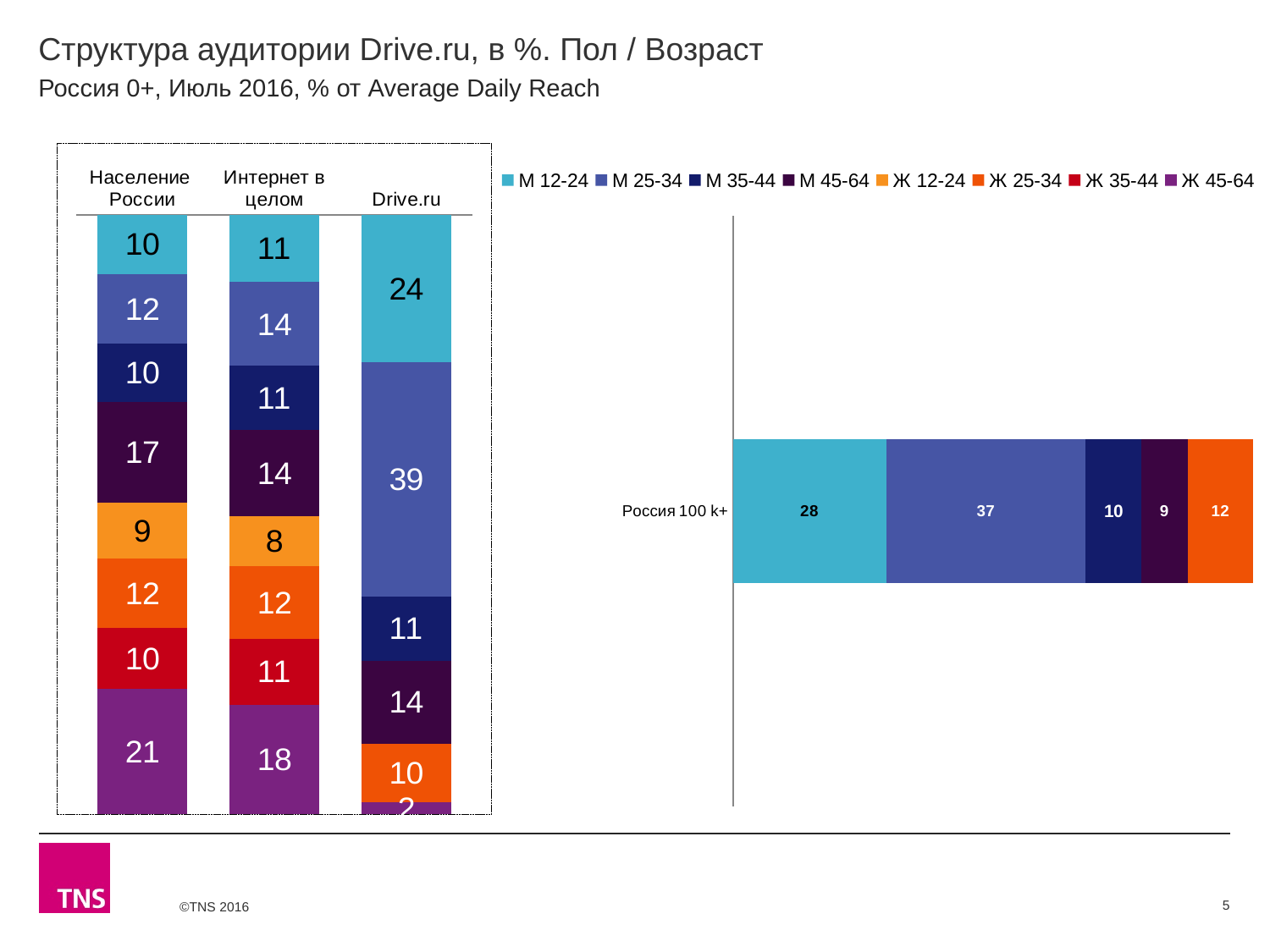
In the right chart, what is the total of all labelled segments in the Россия 100 k+ bar? 96 In the left chart, what is the difference between the Ж 45-64 segments of Население России and Интернет в целом? 3 In the right chart, what is the value of the М 25-34 segment for Россия 100 k+? 37 In the right chart, which segment of the Россия 100 k+ bar is the largest? М 25-34 In the right chart, which segment of the Россия 100 k+ bar is the smallest? М 45-64 In the right chart, what is the difference between the М 25-34 and М 12-24 segments for Россия 100 k+? 9 In the left chart, what is the value of the М 45-64 segment for Интернет в целом? 14 In the left chart, what is the value of the М 25-34 segment for Drive.ru? 39 In the left chart, which has a larger М 12-24 segment: Drive.ru or Интернет в целом? Drive.ru How many series does the legend list? 8 In the left chart, what is the value of the Ж 45-64 segment for Население России? 21 How many stacked bars are shown in the left chart? 3